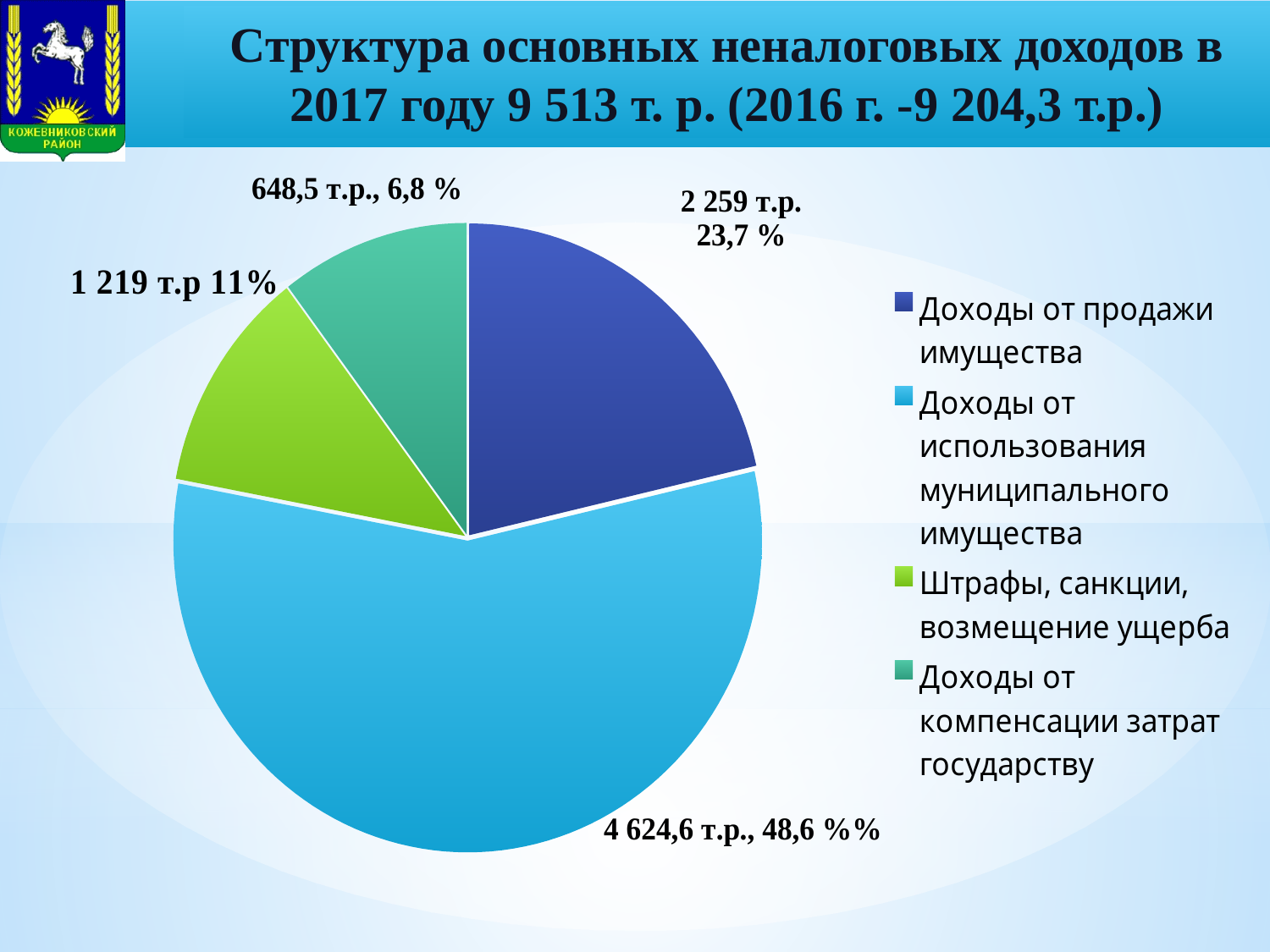
How many slices does the pie chart have? 4 What value is shown for «Доходы от продажи имущества»? 2 259 т.р. What is the difference between the values for «Доходы от использования муниципального имущества» and «Доходы от продажи имущества»? 2 365,6 т.р. Which category has the largest slice of the pie? Доходы от использования муниципального имущества What value is shown for «Доходы от использования муниципального имущества»? 4 624,6 т.р. What value is shown for «Доходы от компенсации затрат государству»? 648,5 т.р. What kind of chart is shown on the slide? pie chart How many entries does the legend list? 4 What value is shown for «Штрафы, санкции, возмещение ущерба»? 1 219 т.р Which category has the smallest slice of the pie? Доходы от компенсации затрат государству What share of the pie does «Штрафы, санкции, возмещение ущерба» represent? 11% Which is larger: «Доходы от продажи имущества» or «Штрафы, санкции, возмещение ущерба»? Доходы от продажи имущества